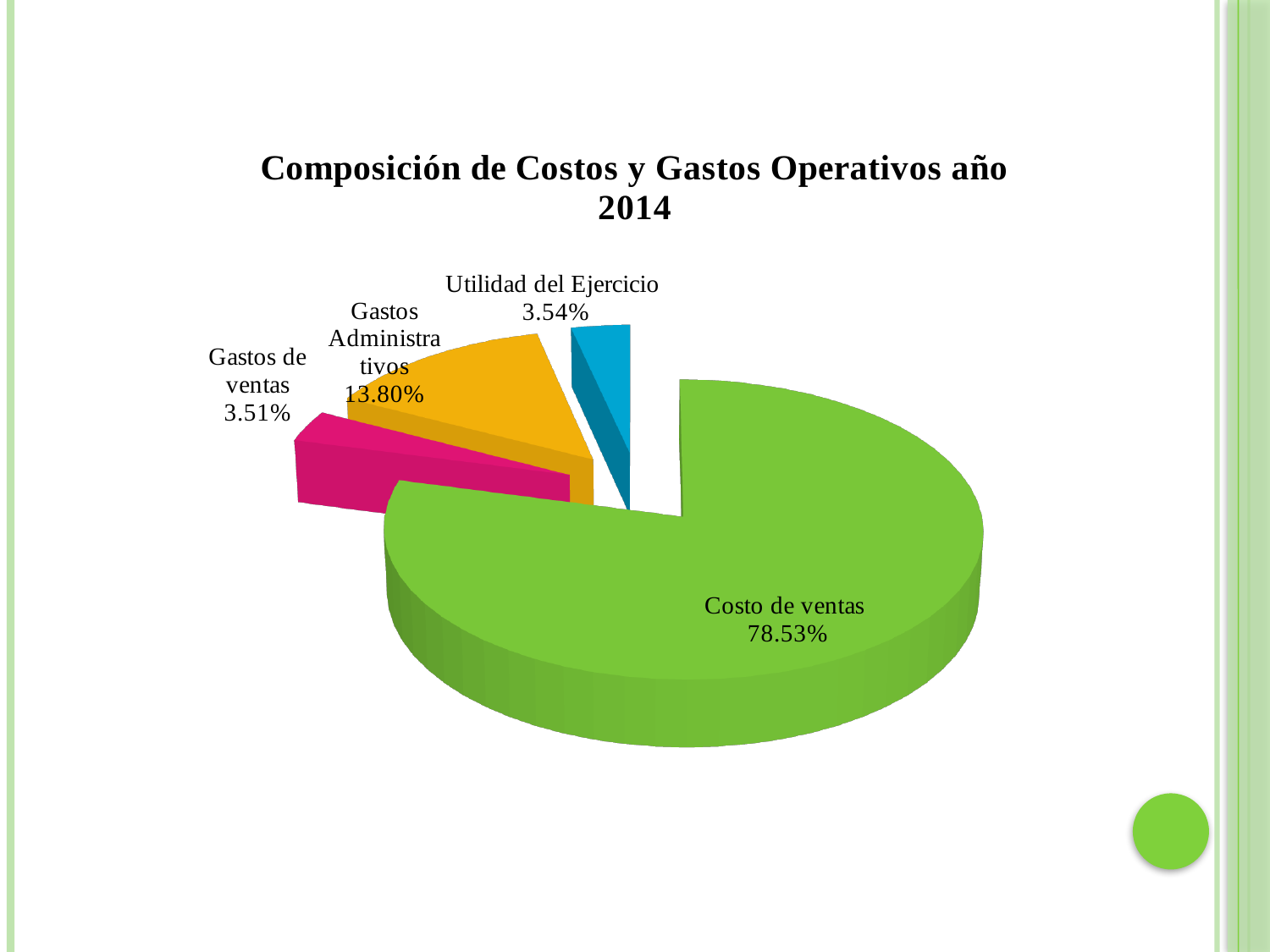
What is the difference in percentage points between Costo de ventas and Gastos Administrativos? 64.73 Which category has the largest slice of the pie? Costo de ventas What is the difference in percentage points between Gastos Administrativos and Utilidad del Ejercicio? 10.26 What is the value shown for Utilidad del Ejercicio? 3.54% What is the title of the chart? Composición de Costos y Gastos Operativos año 2014 What is the value shown for Gastos de ventas? 3.51% What share of the pie does Costo de ventas represent? 78.53% Which is larger, Gastos Administrativos or Utilidad del Ejercicio? Gastos Administrativos What colour is the Costo de ventas slice? Green What is the value shown for Gastos Administrativos? 13.80% How many slices does the pie chart have? 4 What kind of chart is shown on the slide? Pie chart